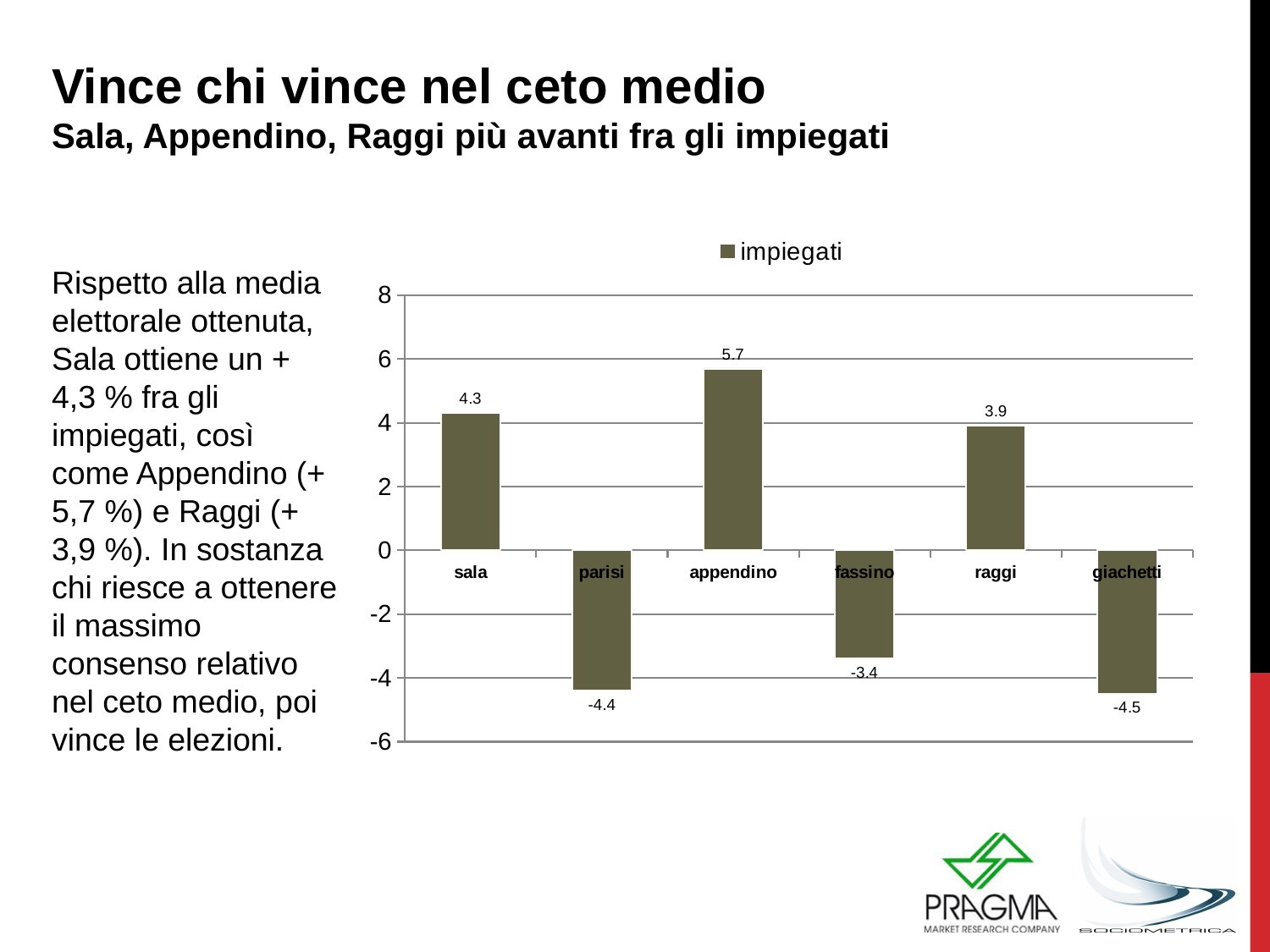
How many categories are shown on the x axis? 6 What is the value for fassino? -3.4 Which category has the highest value? appendino Which category has the lowest value? giachetti What is the value for parisi? -4.4 What is the difference between the values for appendino and raggi? 1.8 What kind of chart is shown on the slide? bar chart What is the value for appendino? 5.7 What series name does the legend show? impiegati What is the value for giachetti? -4.5 What is the value for sala? 4.3 Which is larger, the value for sala or the value for raggi? sala